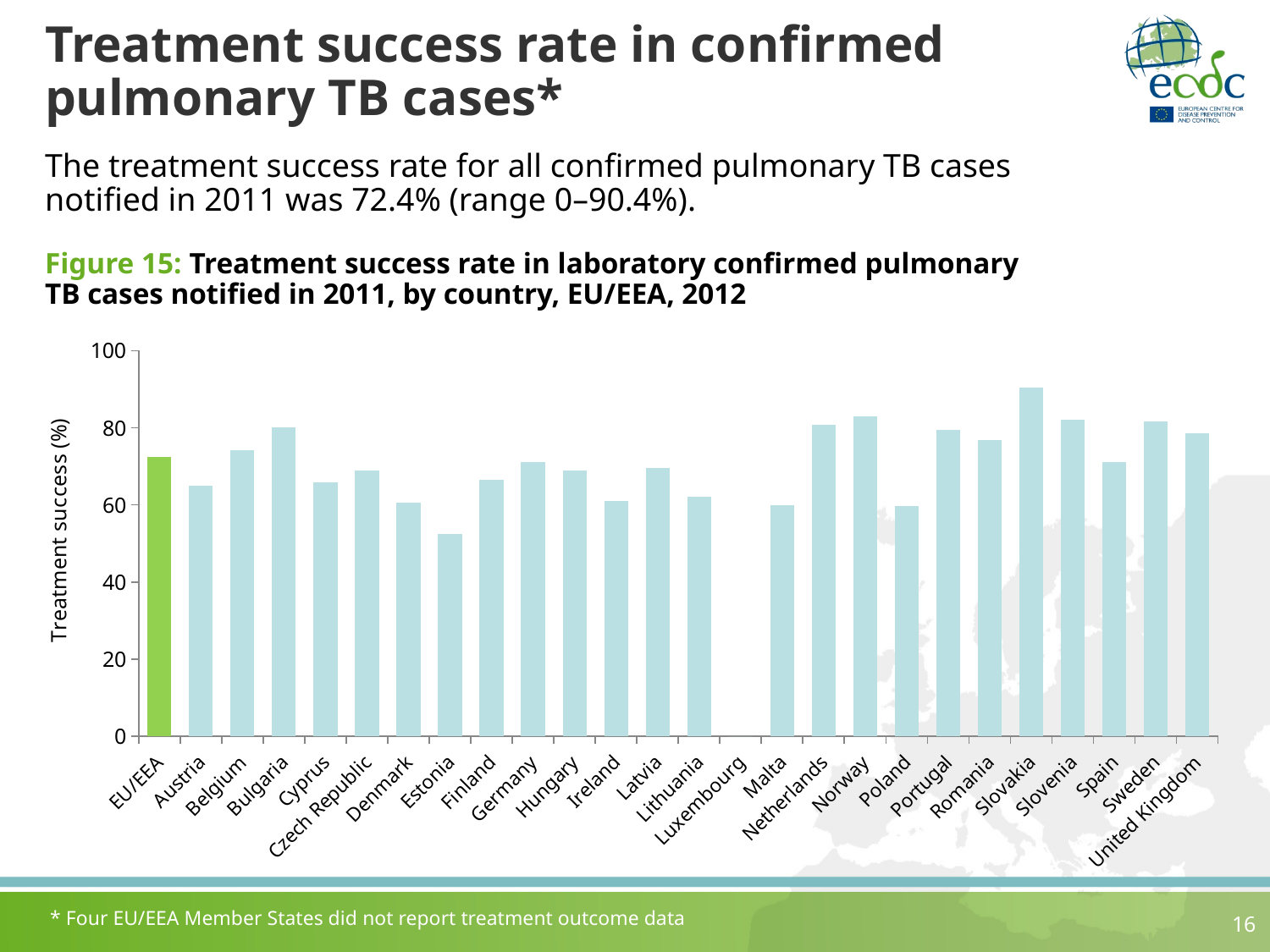
Is the treatment success rate for Romania greater or less than 80? less What kind of chart is shown on the slide? Bar chart Which bar in the chart is coloured green rather than light blue? EU/EEA Is the treatment success rate for Austria greater or less than 60? greater Which has a higher treatment success rate, Bulgaria or Cyprus? Bulgaria Which country has the highest treatment success rate in the chart? Slovakia Is the treatment success rate for Slovakia greater or less than 80? greater Which has a higher treatment success rate, Norway or Austria? Norway How many categories are shown on the x axis of the chart? 26 What is the treatment success rate for EU/EEA, as stated on the slide? 72.4% Excluding Luxembourg, which shows no bar, which country has the lowest treatment success rate? Estonia